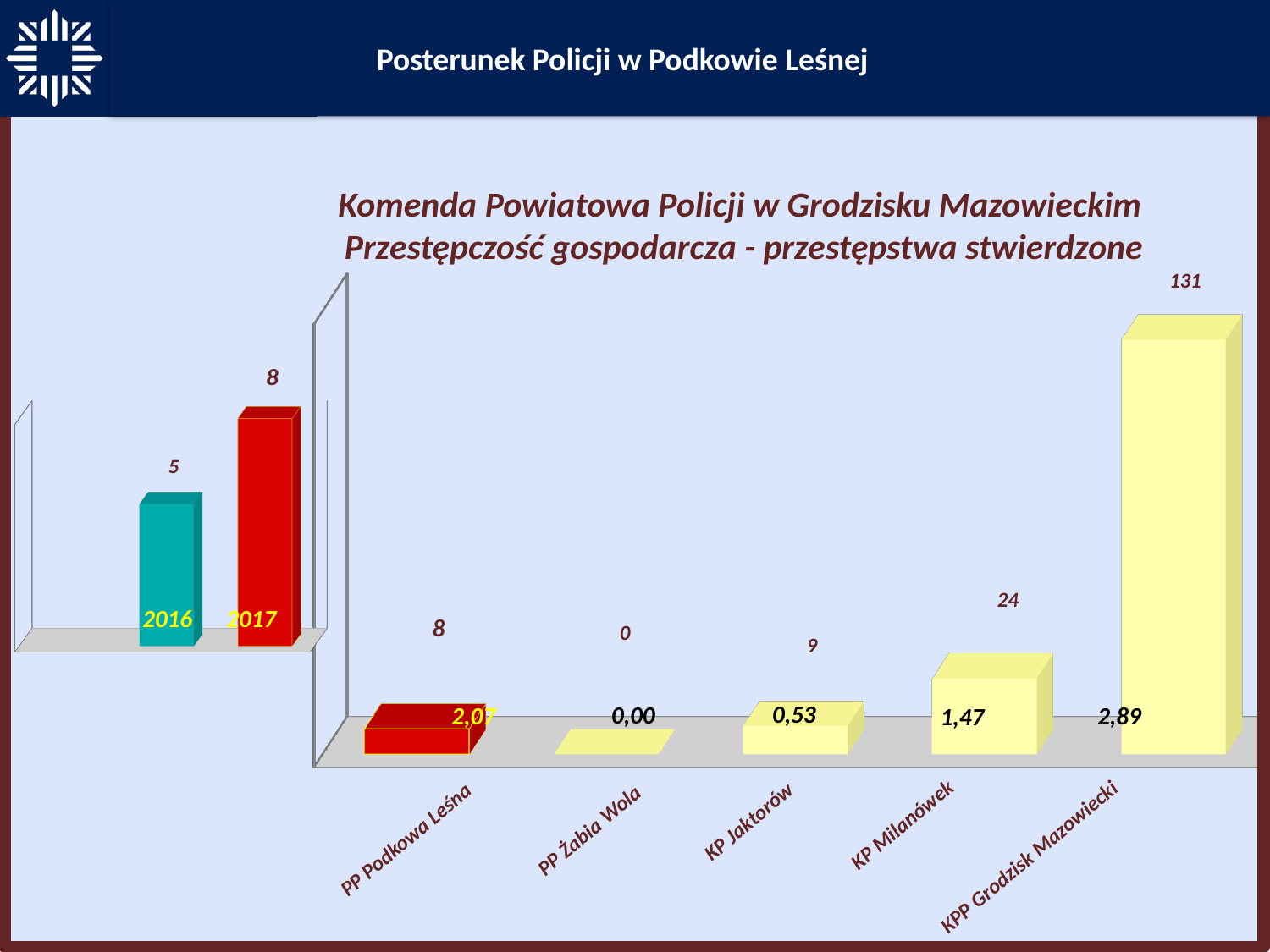
In the small chart on the left, which year has the higher value, 2016 or 2017? 2017 In the small chart on the left, what is the value for 2017? 8 In the chart titled 'Przestępczość gospodarcza - przestępstwa stwierdzone', what is the value for KPP Grodzisk Mazowiecki? 131 In the small chart on the left, what is the difference between the 2017 and 2016 values? 3 In the small chart on the left, what is the value for 2016? 5 In the chart titled 'Przestępczość gospodarcza - przestępstwa stwierdzone', which category has the lowest value? PP Żabia Wola In the chart titled 'Przestępczość gospodarcza - przestępstwa stwierdzone', what is the value for KP Milanówek? 24 In the chart titled 'Przestępczość gospodarcza - przestępstwa stwierdzone', which category has the highest value? KPP Grodzisk Mazowiecki In the chart titled 'Przestępczość gospodarcza - przestępstwa stwierdzone', what is the value for PP Żabia Wola? 0 In the chart titled 'Przestępczość gospodarcza - przestępstwa stwierdzone', what is the difference between the values for KPP Grodzisk Mazowiecki and KP Milanówek? 107 In the chart titled 'Przestępczość gospodarcza - przestępstwa stwierdzone', what secondary label is printed at the base of the KP Jaktorów bar? 0,53 In the chart titled 'Przestępczość gospodarcza - przestępstwa stwierdzone', how many categories are shown on the x axis? 5